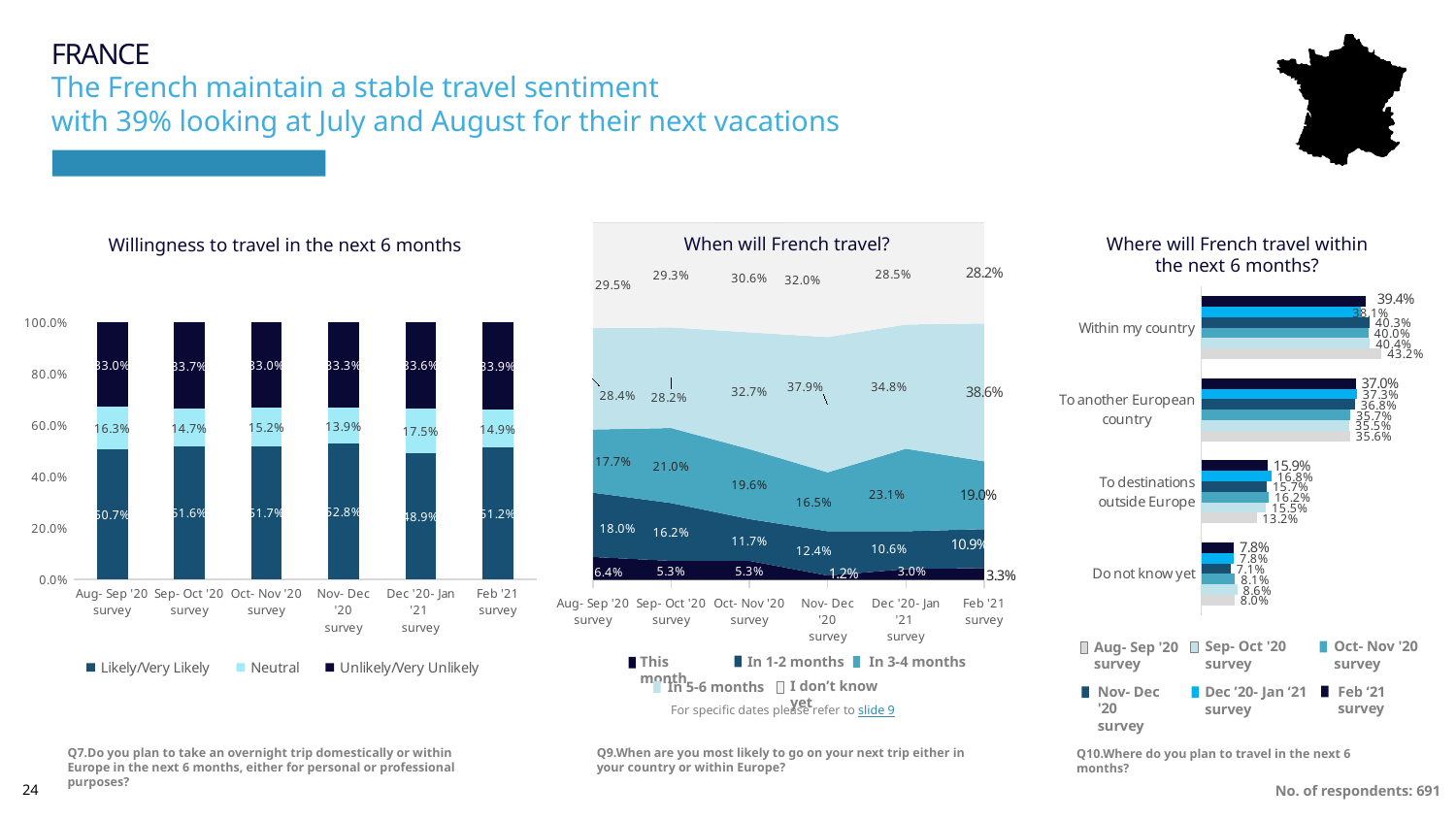
In the 'Willingness to travel in the next 6 months' chart, how many series does the legend list? 3 What kind of chart is 'Where will French travel within the next 6 months?' Bar chart In the 'Willingness to travel in the next 6 months' chart, which survey has the highest Likely/Very Likely value? Nov- Dec '20 survey In the 'When will French travel?' chart, what is the 'This month' value for the Nov- Dec '20 survey? 1.2% In the 'Willingness to travel in the next 6 months' chart, what is the Likely/Very Likely value for the Feb '21 survey? 51.2% In the 'Willingness to travel in the next 6 months' chart, what is the difference between the Neutral values for the Dec '20- Jan '21 survey and the Nov- Dec '20 survey? 3.6% In the 'When will French travel?' chart, how many surveys are shown on the x axis? 6 In the 'When will French travel?' chart, what is the 'In 5-6 months' value for the Feb '21 survey? 38.6% In the 'Where will French travel within the next 6 months?' chart, what is the highest value shown for 'Within my country'? 43.2% In the 'Willingness to travel in the next 6 months' chart, what is the Neutral value for the Dec '20- Jan '21 survey? 17.5% In the 'Willingness to travel in the next 6 months' chart, which survey has the lowest Likely/Very Likely value? Dec '20- Jan '21 survey In the 'When will French travel?' chart, which survey has the highest 'In 3-4 months' value? Dec '20- Jan '21 survey